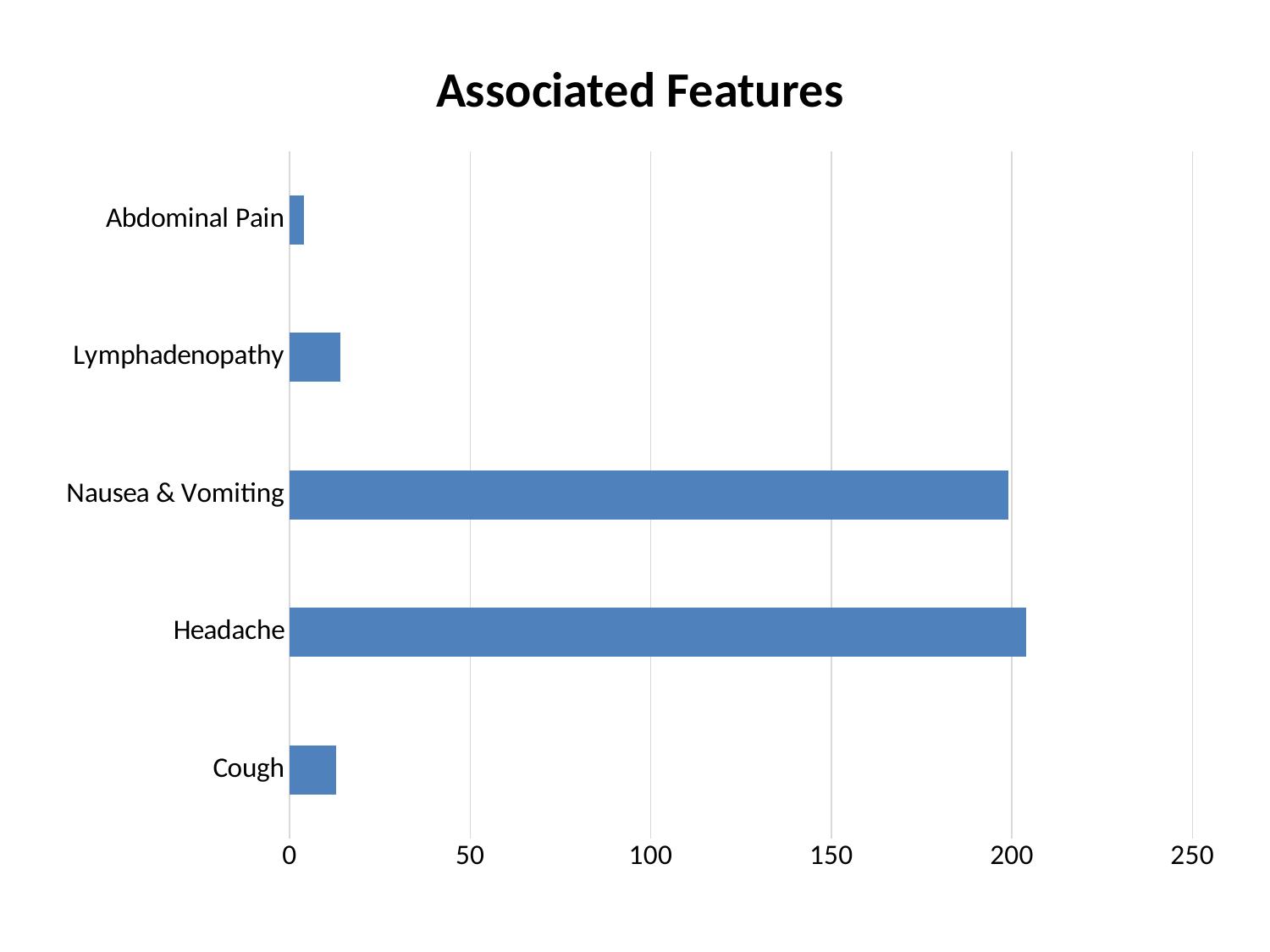
What kind of chart is shown on the slide? bar chart Which is larger, the value for Abdominal Pain or the value for Nausea & Vomiting? Nausea & Vomiting Is the value for Lymphadenopathy greater or less than 50? less How many categories are plotted in the chart? 5 What is the title of the chart? Associated Features Is the value for Cough greater or less than 50? less Which is larger, the value for Headache or the value for Cough? Headache Is the value for Headache greater or less than 200? greater Which category has the lowest value? Abdominal Pain Which category has the highest value? Headache What is the highest value shown on the horizontal axis? 250